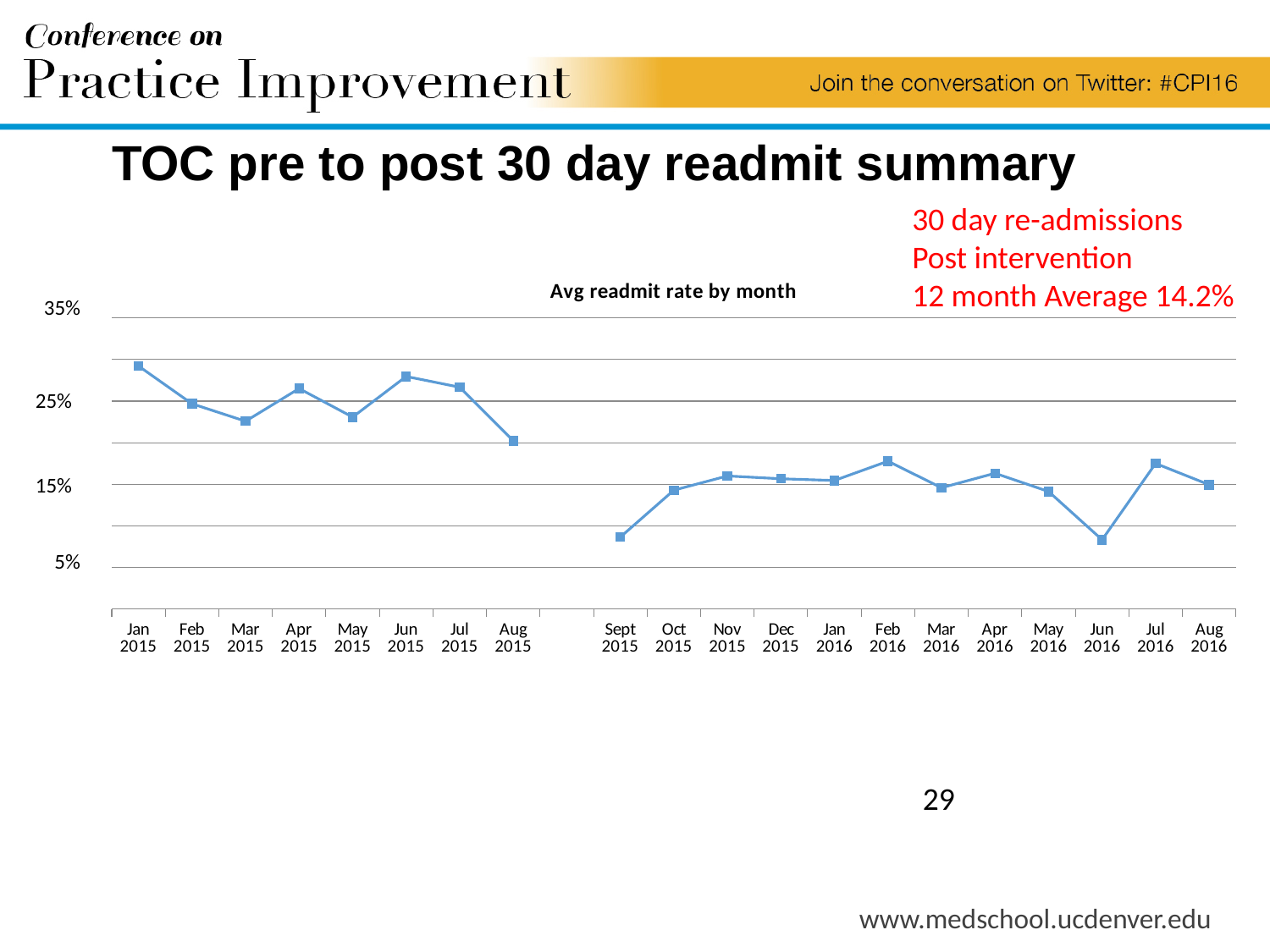
What is the title of the chart? Avg readmit rate by month Which month has the highest average readmit rate in the chart? Jan 2015 Is the value for Feb 2016 greater or less than 15%? greater Is the value for Jan 2015 greater or less than 25%? greater How many months are plotted on the x axis of the chart? 20 Is the value for Jun 2016 greater or less than 15%? less What kind of chart is shown on the slide? line chart Overall, do the values rise or fall from Jan 2015 to Aug 2015? fall Which is larger, the value for Jan 2015 or the value for Sept 2015? Jan 2015 Which is larger, the value for Feb 2016 or the value for Jun 2016? Feb 2016